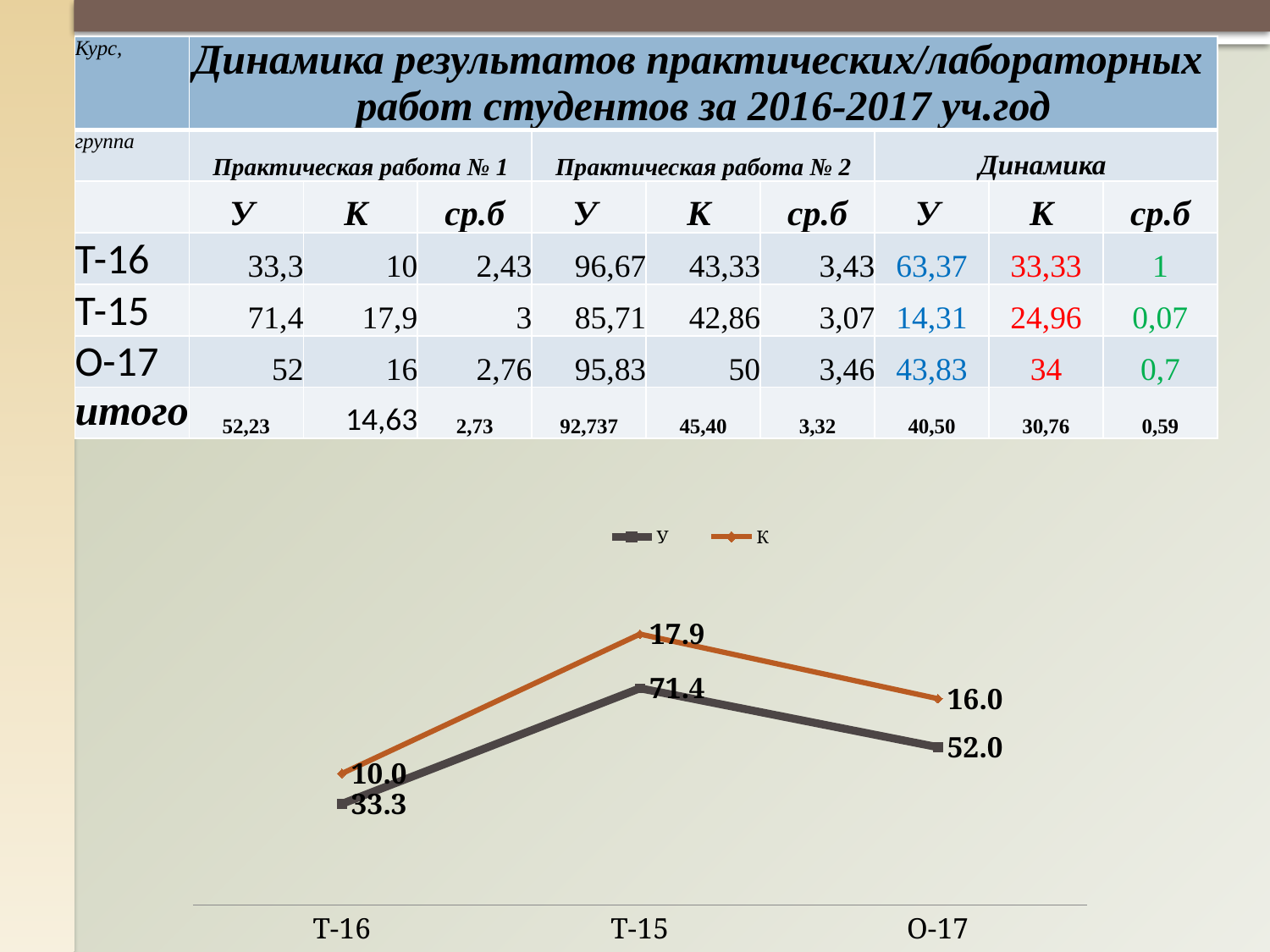
What is the value of the К series for Т-16 in the chart? 10.0 Which category has the highest value in the У series? Т-15 How many categories are shown on the x axis of the chart? 3 What is the value of the У series for Т-15 in the chart? 71.4 Which series is drawn in orange in the chart? К How many series does the chart legend list? 2 What kind of chart is shown on the slide? line chart Which category has the lowest value in the К series? Т-16 What is the value of the К series for О-17 in the chart? 16.0 What is the value of the У series for Т-16 in the chart? 33.3 What is the difference between the У values for Т-15 and Т-16? 38.1 Which is larger in the К series: the value for Т-15 or the value for О-17? Т-15